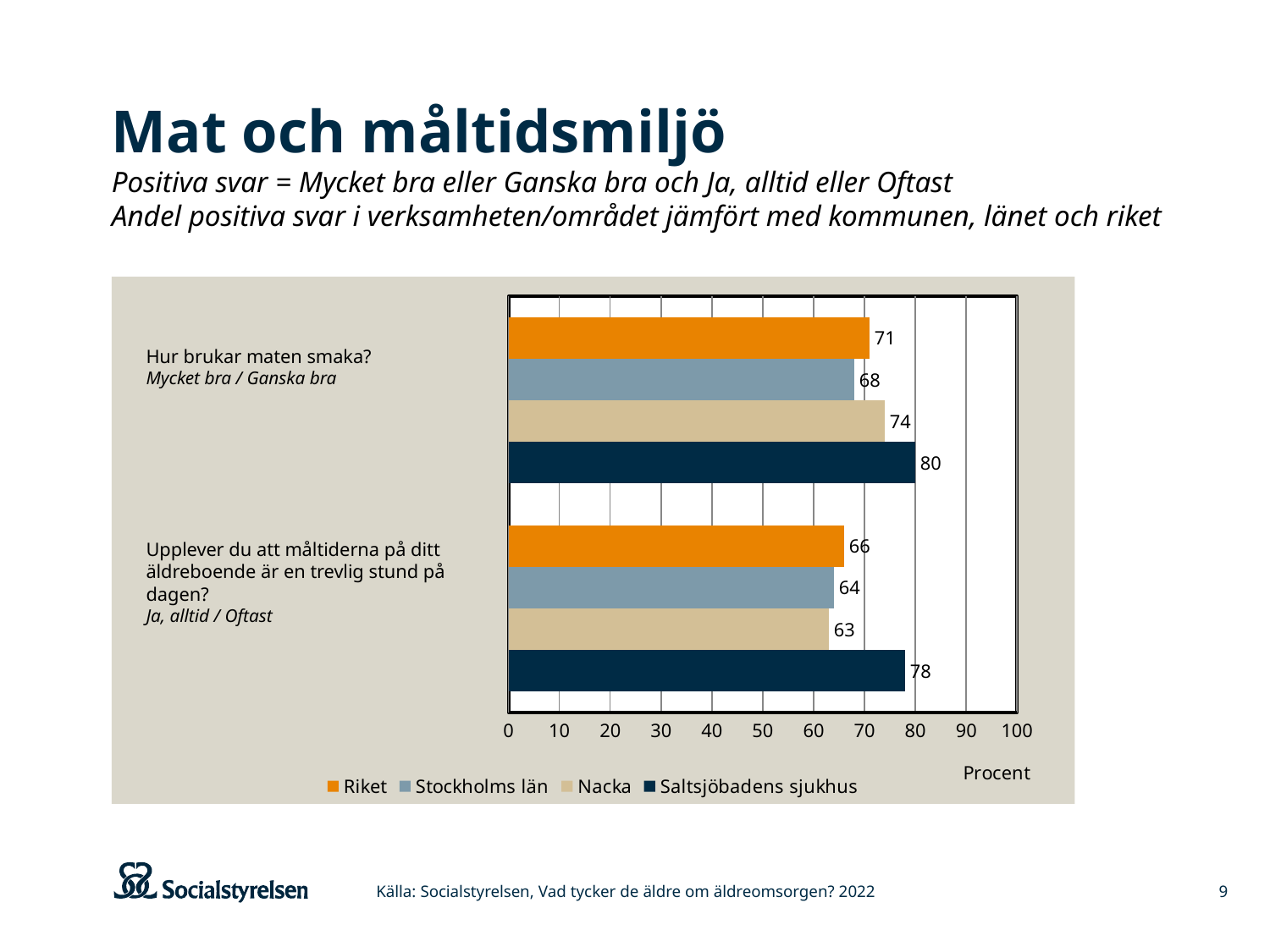
What unit is shown on the x axis of the chart? Procent Which series has the lowest value for the question "Upplever du att måltiderna på ditt äldreboende är en trevlig stund på dagen?"? Nacka How many series does the legend list? 4 What kind of chart is shown on the slide? Bar chart What is the value for Saltsjöbadens sjukhus for the question "Hur brukar maten smaka?"? 80 What is the difference between Saltsjöbadens sjukhus and Nacka for the question "Upplever du att måltiderna på ditt äldreboende är en trevlig stund på dagen?"? 15 Which is larger for the question "Hur brukar maten smaka?": Riket or Stockholms län? Riket What is the value for Stockholms län for the question "Upplever du att måltiderna på ditt äldreboende är en trevlig stund på dagen?"? 64 What is the value for Riket for the question "Upplever du att måltiderna på ditt äldreboende är en trevlig stund på dagen?"? 66 Which series has the highest value for the question "Hur brukar maten smaka?"? Saltsjöbadens sjukhus What is the difference between Saltsjöbadens sjukhus and Riket for the question "Hur brukar maten smaka?"? 9 What is the value for Nacka for the question "Hur brukar maten smaka?"? 74